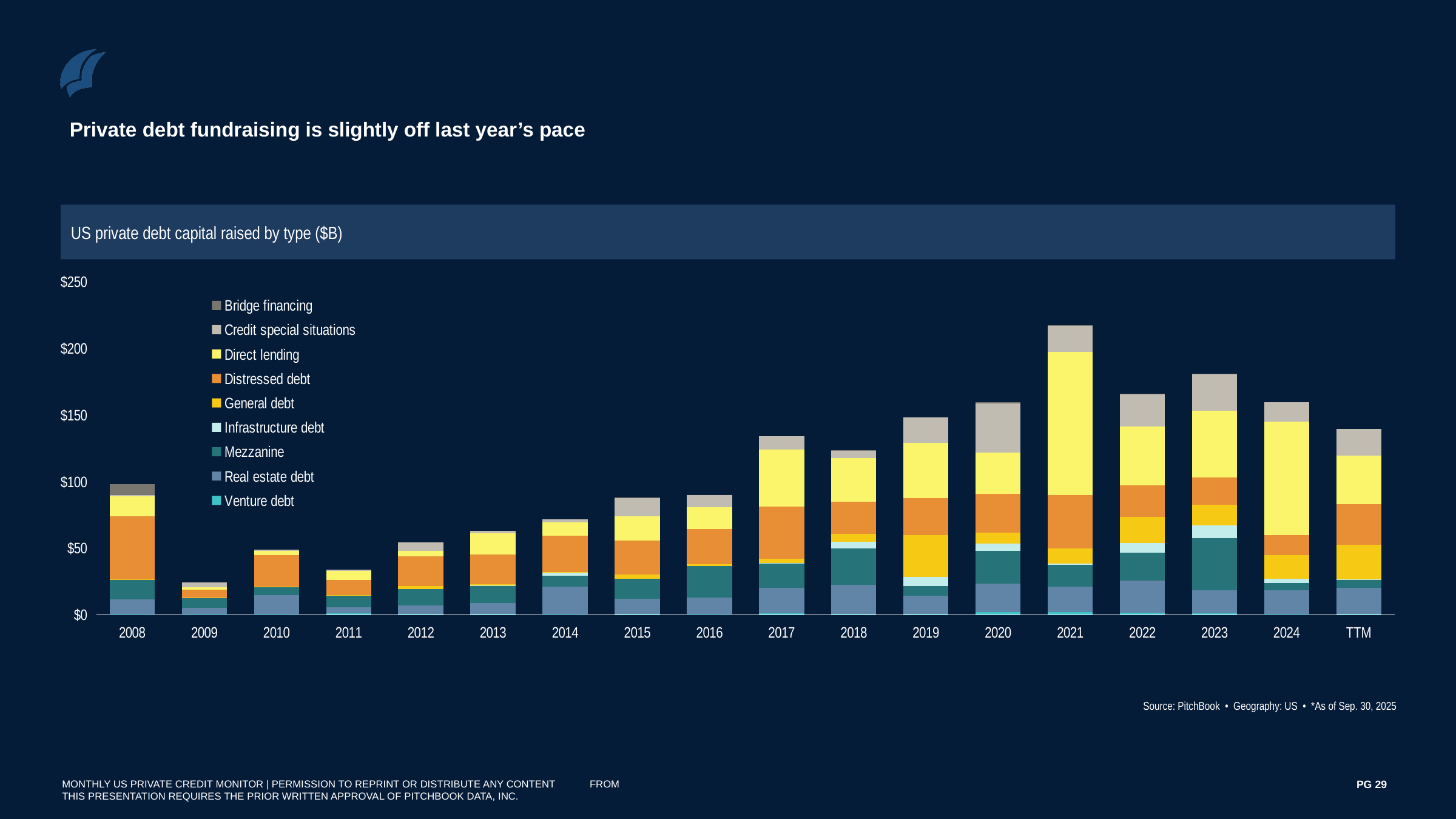
Which year has the tallest stacked bar? 2021 What kind of chart is shown on the slide? Stacked bar chart Which bar is taller, 2021 or 2024? 2021 What is the title of the chart? US private debt capital raised by type ($B) Which year has the shortest stacked bar? 2009 Is the total bar for TTM greater or less than $150? less How many bars (years including TTM) are shown on the x axis? 18 Is the total bar for 2011 greater or less than $50? less Is the total bar for 2021 greater or less than $200? greater How many series does the legend list? 9 Which series is shown in bright yellow in the legend? Direct lending